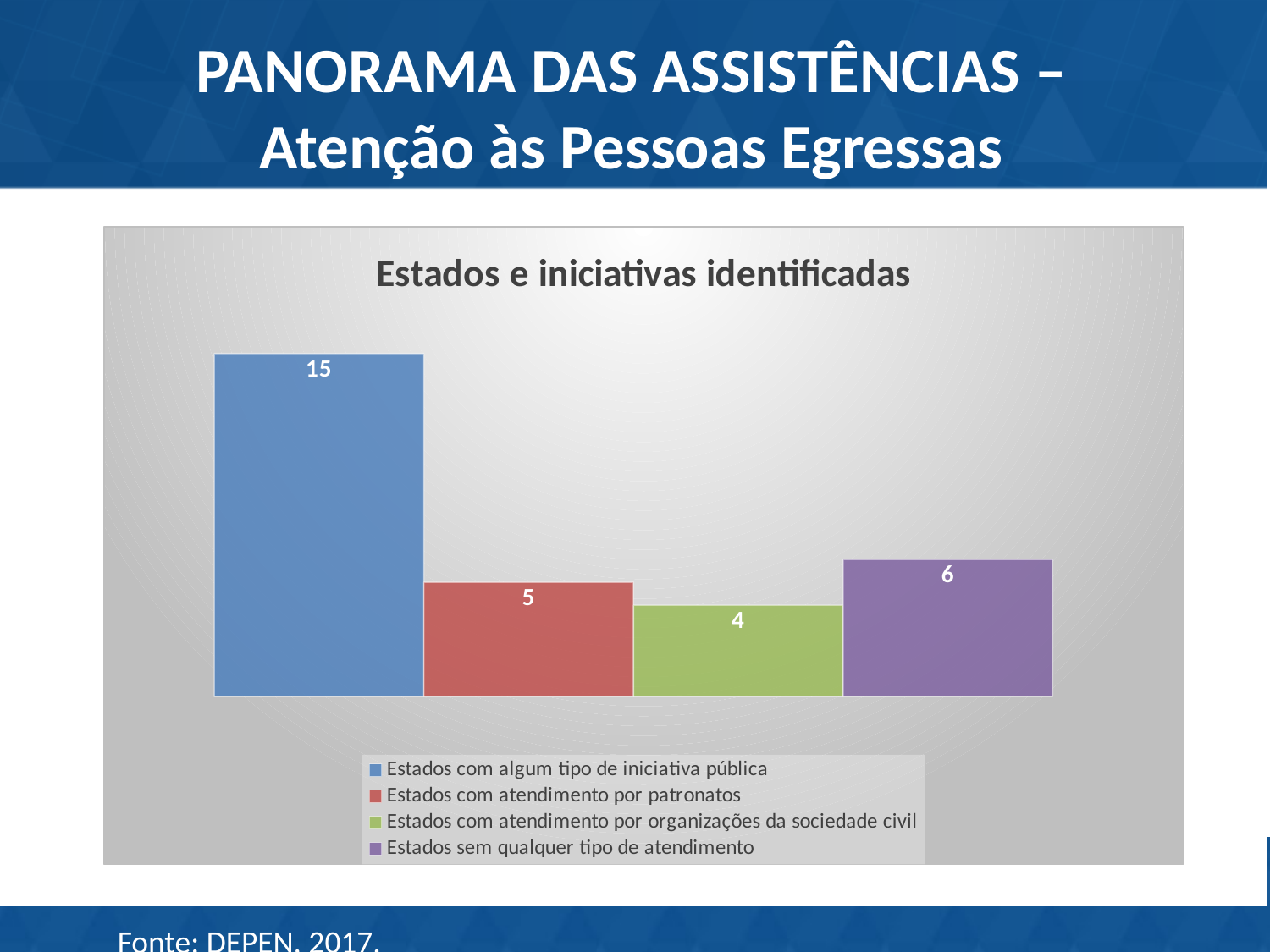
How many series does the legend list? 4 Which series has the highest value? Estados com algum tipo de iniciativa pública What is the title of the chart? Estados e iniciativas identificadas What is the value for 'Estados com atendimento por patronatos'? 5 What is the value for 'Estados sem qualquer tipo de atendimento'? 6 What is the value for 'Estados com algum tipo de iniciativa pública'? 15 Which is larger: the value for 'Estados com atendimento por patronatos' or the value for 'Estados sem qualquer tipo de atendimento'? Estados sem qualquer tipo de atendimento What kind of chart is shown on the slide? Bar chart Which series has the lowest value? Estados com atendimento por organizações da sociedade civil What is the difference between the value for 'Estados com algum tipo de iniciativa pública' and the value for 'Estados sem qualquer tipo de atendimento'? 9 What is the value for 'Estados com atendimento por organizações da sociedade civil'? 4 What colour is the bar for 'Estados sem qualquer tipo de atendimento'? Purple